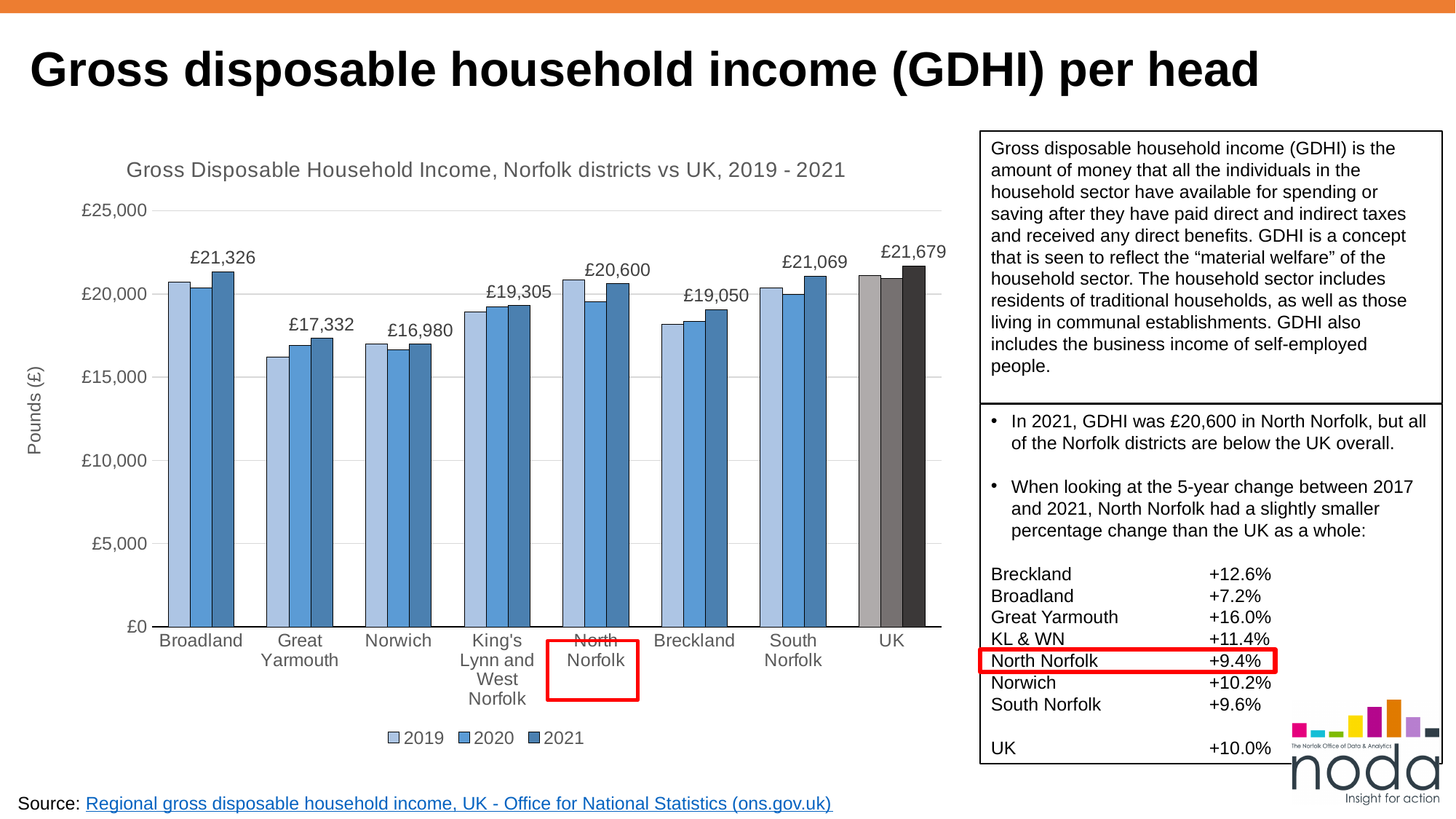
What was the 2021 GDHI per head for the UK? £21,679 What kind of chart is shown on the slide? Bar chart Is the 2019 value for Great Yarmouth greater or less than £20,000? less What is the difference between the 2021 GDHI per head for Broadland and South Norfolk? £257 Which area had the lowest 2021 GDHI per head? Norwich How many areas are shown on the x axis of the chart? 8 Which had a higher 2021 GDHI per head, King's Lynn and West Norfolk or Breckland? King's Lynn and West Norfolk How many series does the chart legend list? 3 What was the 2021 GDHI per head for North Norfolk? £20,600 What is the difference between the UK's 2021 GDHI per head and North Norfolk's? £1,079 Which area had the highest 2021 GDHI per head? UK What was the 2021 GDHI per head for Great Yarmouth? £17,332